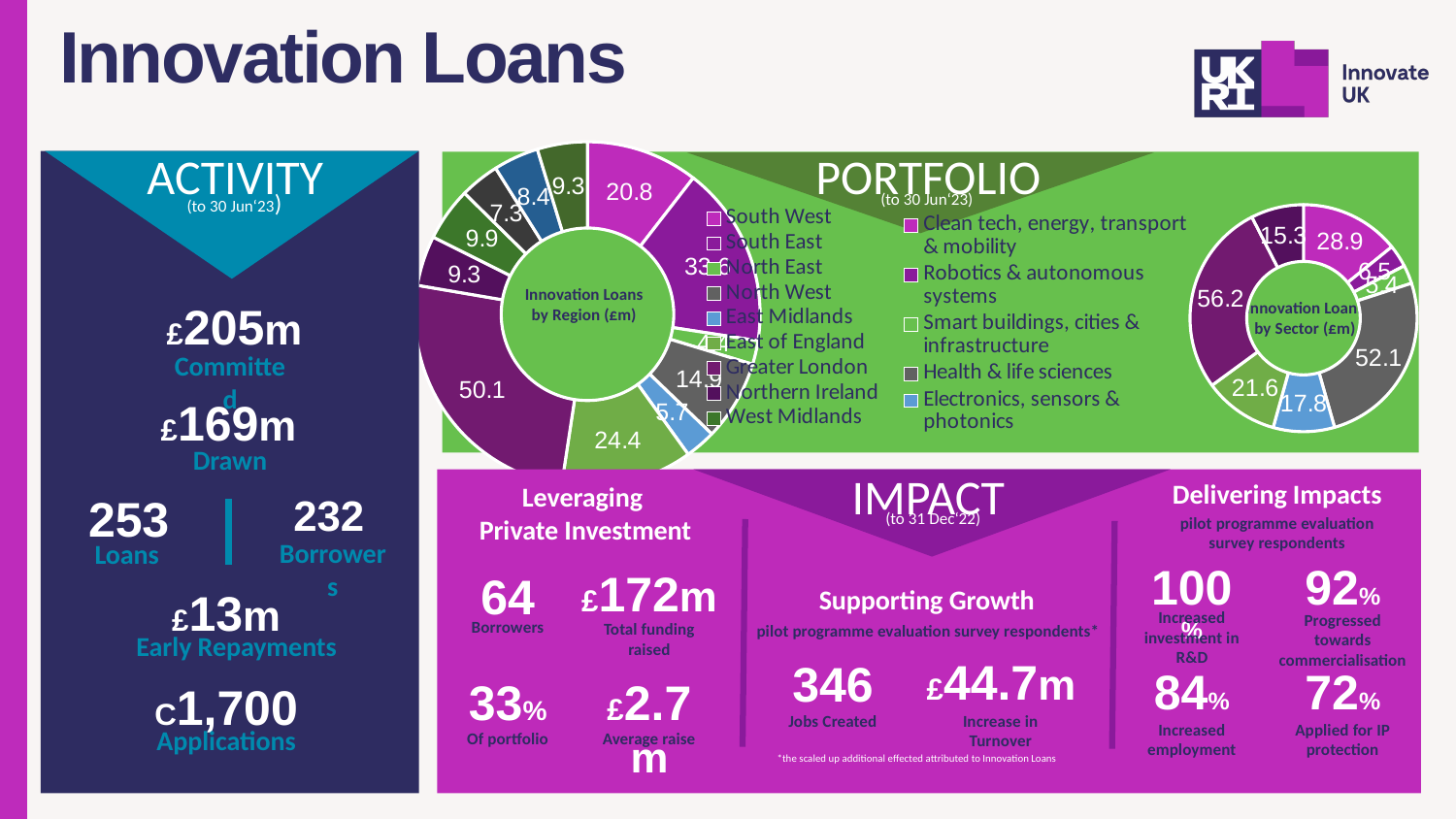
How many entries does the legend of the 'Innovation Loans by Sector (£m)' chart list? 5 What kind of chart is the 'Innovation Loans by Sector (£m)' chart? doughnut chart In the 'Innovation Loans by Sector (£m)' chart, what is the largest value shown on any slice? 56.2 In the 'Innovation Loans by Sector (£m)' chart, what is the difference between the two largest slices, 56.2 and 52.1? 4.1 In the 'Innovation Loans by Sector (£m)' chart, what is the smallest value shown on any slice? 5.4 In the 'Innovation Loans by Sector (£m)' chart, which is larger, the slice labelled 28.9 or the slice labelled 21.6? 28.9 In the 'Innovation Loans by Region (£m)' chart, what is the largest value shown on any slice? 50.1 What kind of chart is the 'Innovation Loans by Region (£m)' chart? doughnut chart What unit is stated in the title of the 'Innovation Loans by Sector' chart? £m What is the title shown in the centre of the left doughnut chart in the Portfolio section? Innovation Loans by Region (£m) In the 'Innovation Loans by Region (£m)' chart, which is larger, the slice labelled 24.4 or the slice labelled 20.8? 24.4 In the 'Innovation Loans by Region (£m)' chart, what is the difference between the slices labelled 50.1 and 33.6? 16.5